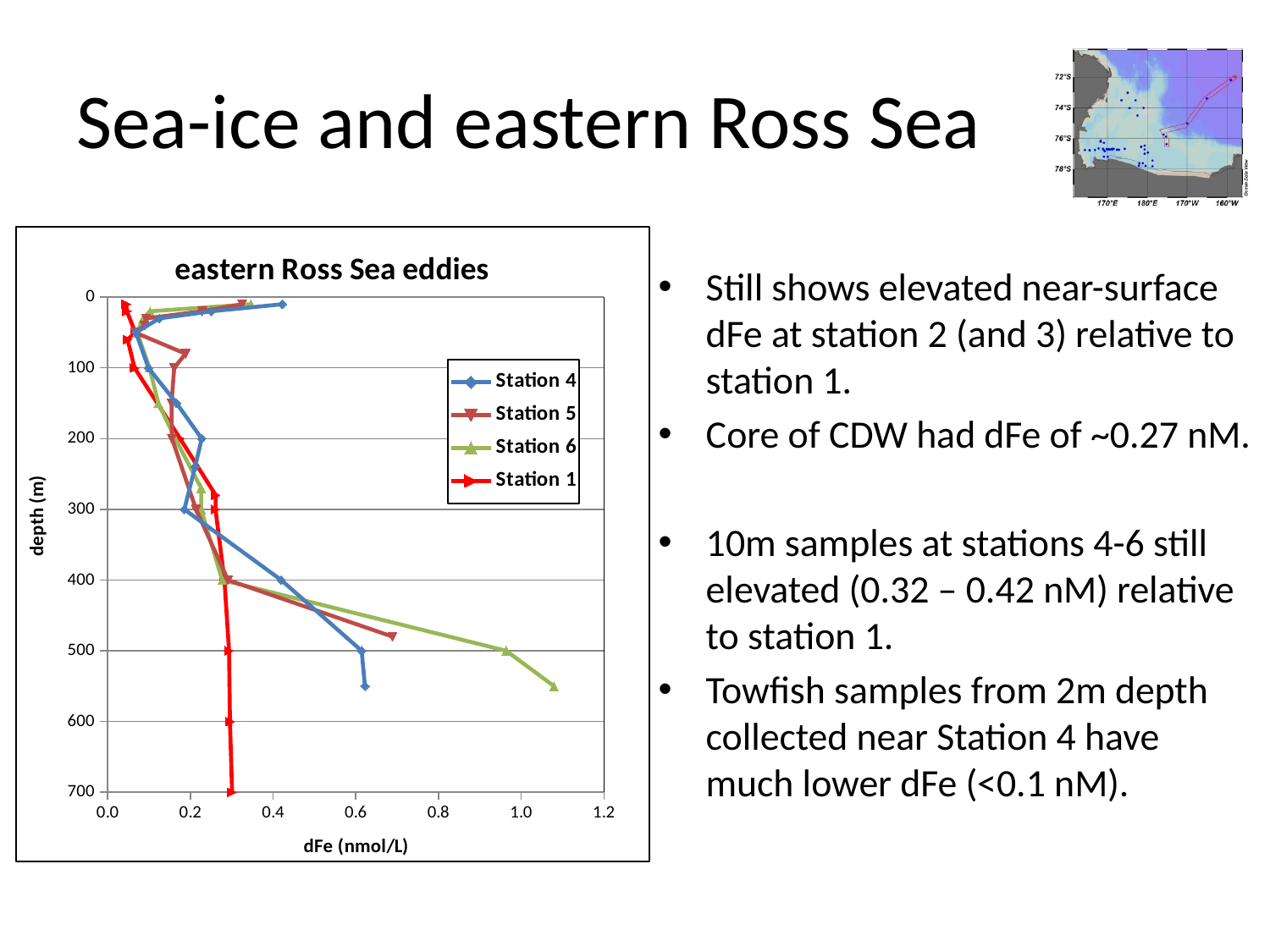
What is the label of the x axis of the chart? dFe (nmol/L) What is the title of the chart? eastern Ross Sea eddies Is the dFe value for Station 6 at 550 m depth greater or less than 1.0? greater Is the dFe value for Station 1 at 100 m depth greater or less than 0.2? less Is the dFe value for Station 1 at 700 m depth greater or less than 0.4? less What kind of chart is shown on the slide? line chart At 550 m depth, which has the larger dFe value, Station 6 or Station 4? Station 6 How many series does the legend of the chart list? 4 Which station has the lowest dFe value at the shallowest (10 m) sample? Station 1 Which station reaches the highest dFe value on the chart? Station 6